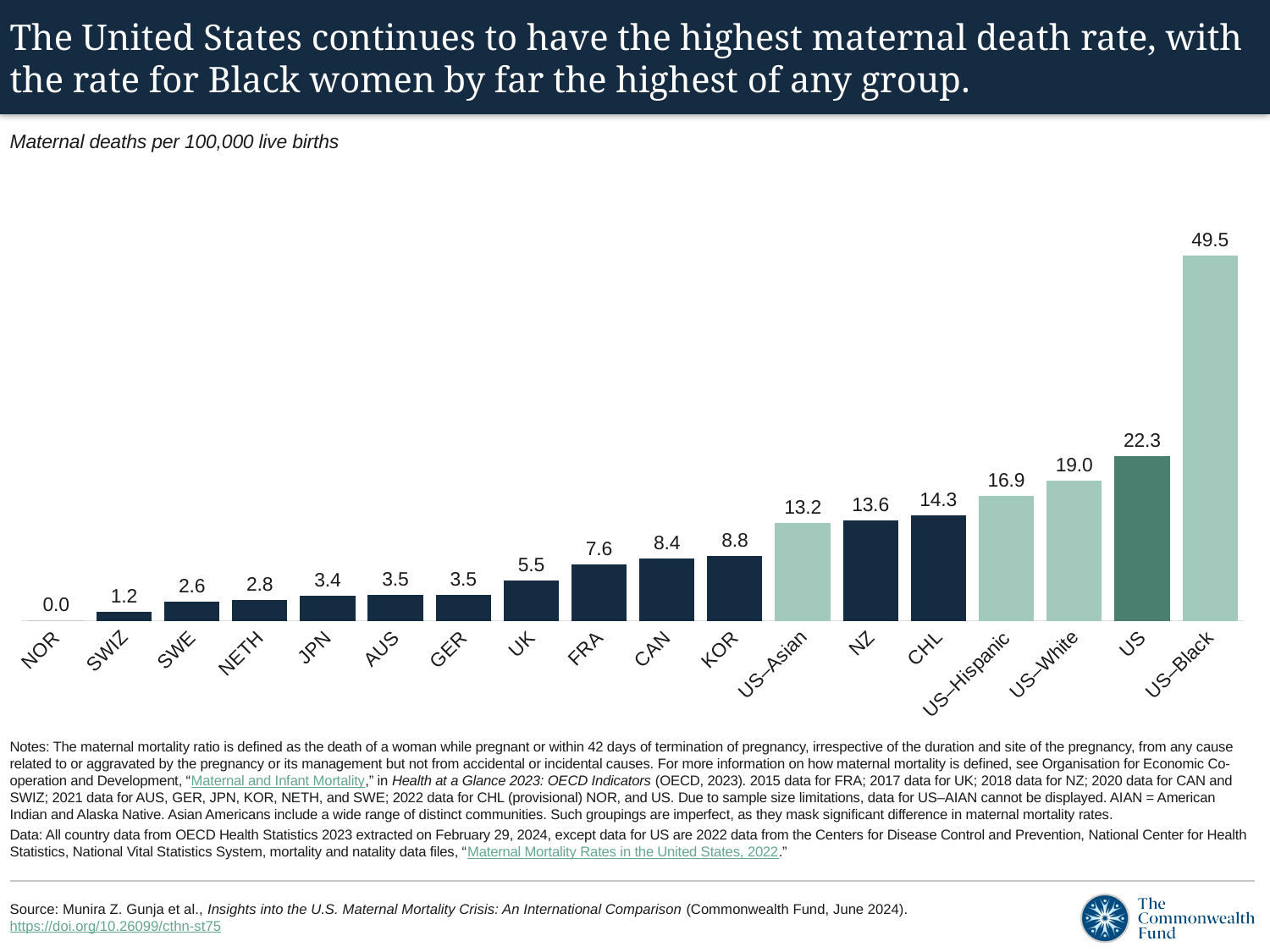
What is the value shown for the US overall? 22.3 What is the value shown for the UK? 5.5 How many categories are shown on the x axis? 18 What kind of chart is shown on the slide? Bar chart What is the value shown for CHL? 14.3 What is the maternal death rate per 100,000 live births for US–Black women? 49.5 Which category has the highest maternal death rate? US–Black What is the difference between the values for US–Black and US–White? 30.5 Which category has the lowest maternal death rate? NOR What is the difference between the values for the US and CHL? 8.0 Which has a higher value, NZ or US–Asian? NZ Do the values generally rise or fall moving from left to right along the x axis? Rise